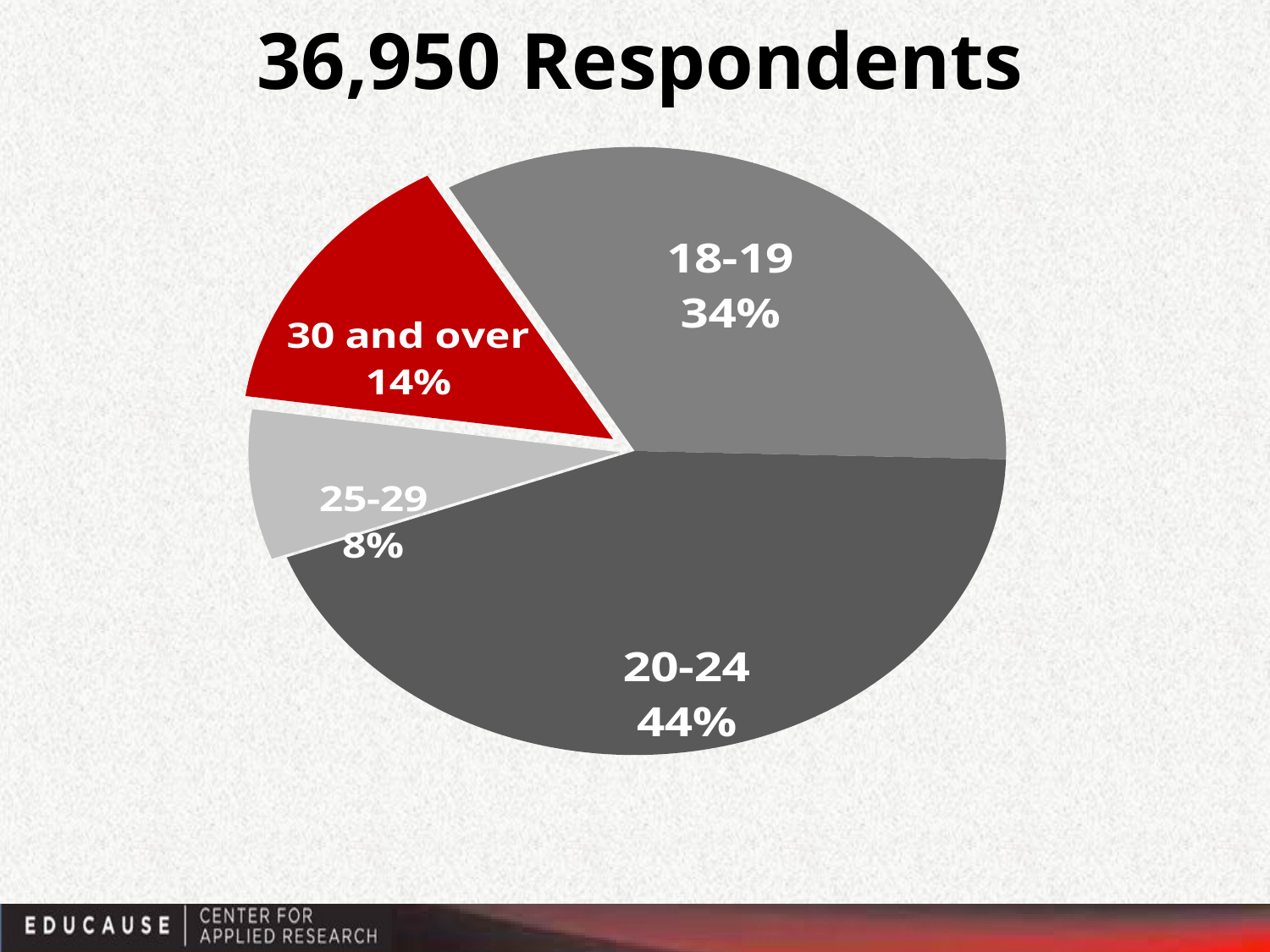
How many age groups are shown in the pie chart? 4 How many percentage points larger is the 20-24 share than the 18-19 share? 10 Which age group has the smallest share of respondents? 25-29 What is the difference in percentage points between the 30 and over share and the 25-29 share? 6 What share of respondents are aged 20-24? 44% Which age group has the largest share of respondents? 20-24 Which slice of the pie chart is coloured red? 30 and over What kind of chart is shown on the slide? pie chart What share of respondents are aged 18-19? 34% What share of respondents are aged 25-29? 8% Which is larger, the share for 30 and over or the share for 25-29? 30 and over What share of respondents are 30 and over? 14%